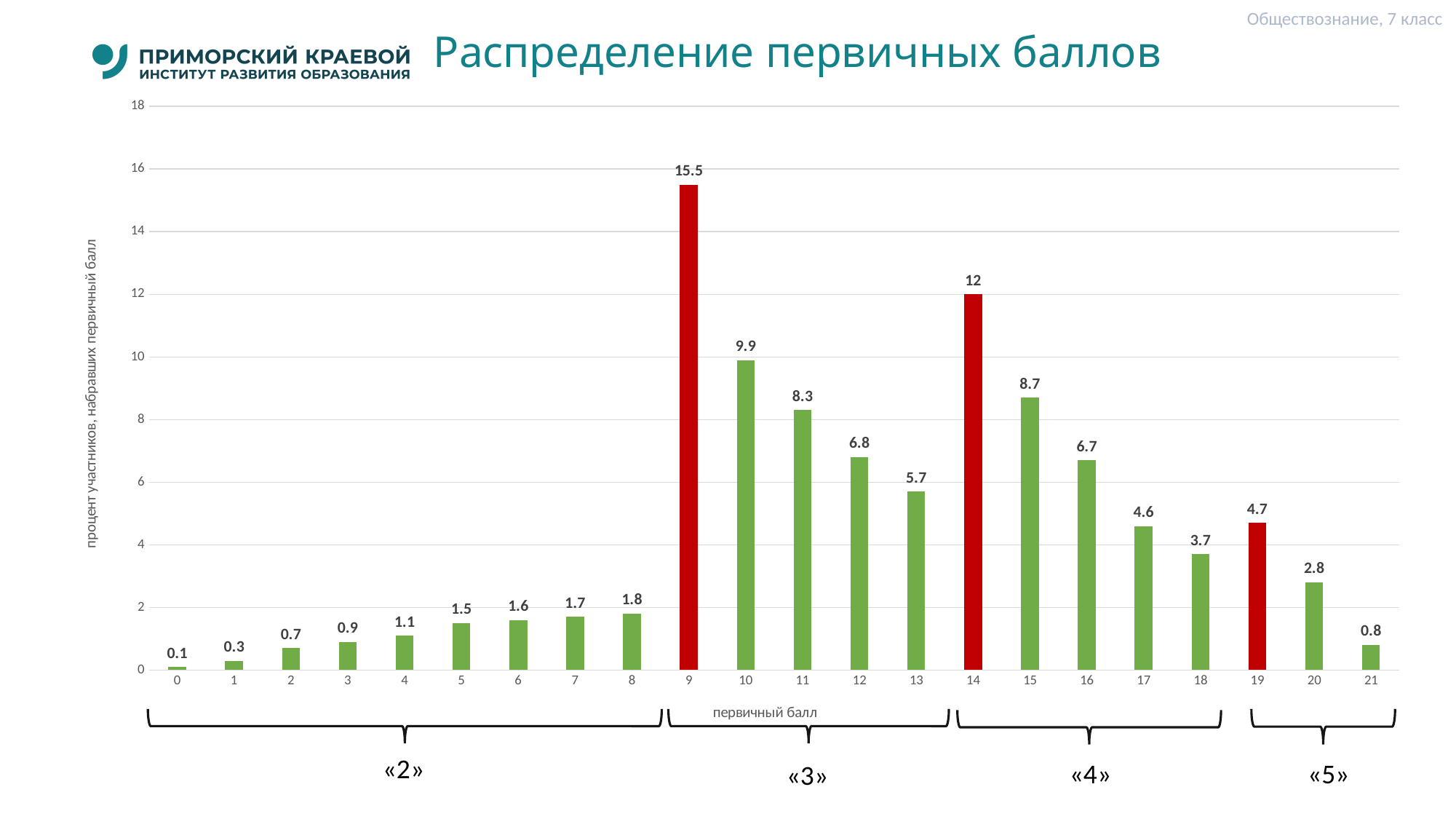
What is the value for primary score 9? 15.5 Do the values rise or fall from primary score 0 to primary score 8? rise What is the difference between the values for primary scores 10 and 13? 4.2 Which primary score has the highest percentage of participants? 9 Is the value for primary score 19 greater or less than 4? greater What kind of chart is shown on the slide? bar chart Which is larger, the value for primary score 15 or for primary score 11? 15 What is the value for primary score 17? 4.6 How many primary score categories are shown on the x axis? 22 Which primary score has the lowest percentage of participants? 0 What is the value for primary score 14? 12 What is the difference between the values for primary scores 9 and 14? 3.5